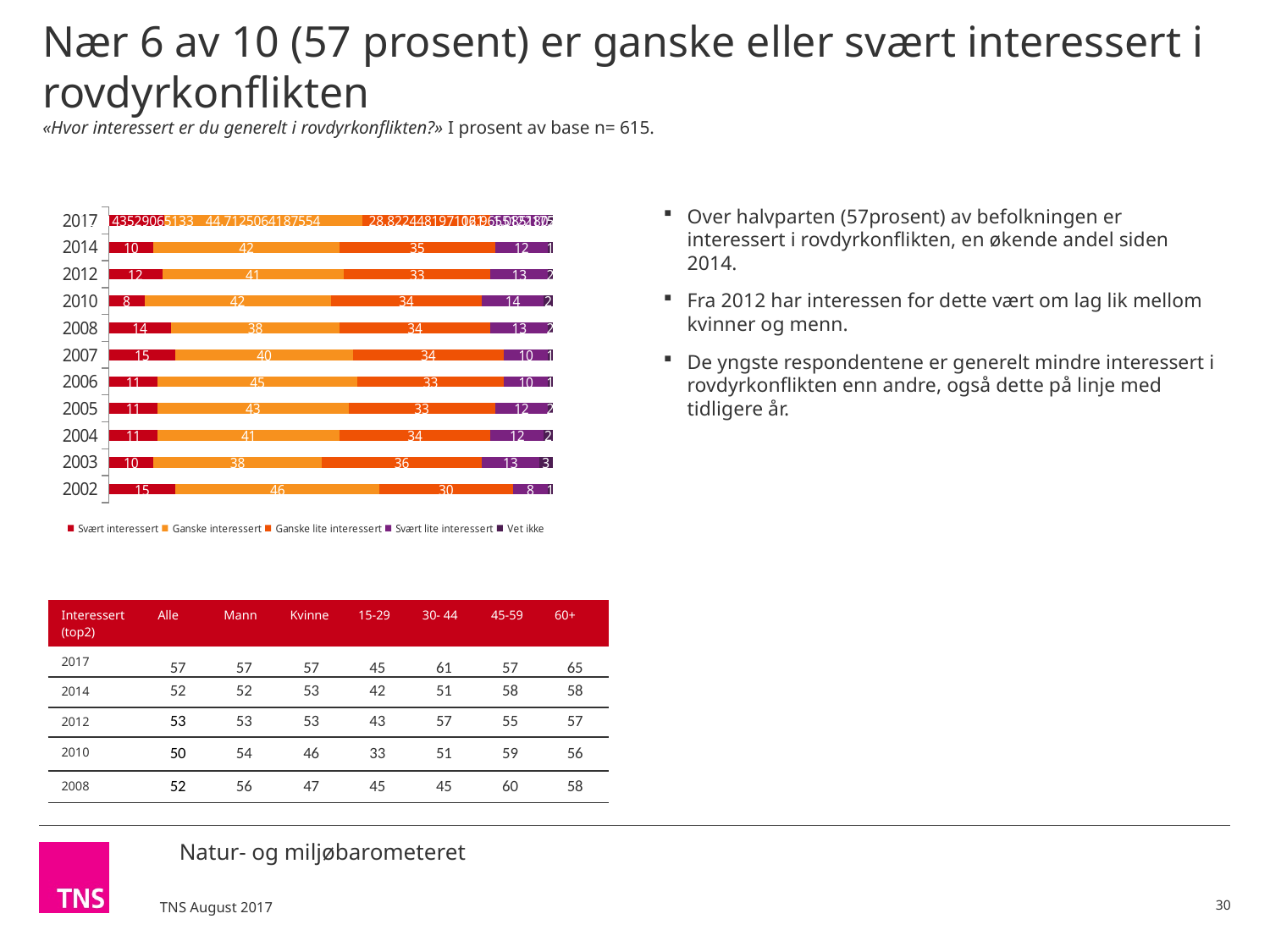
In which year is the 'Svært interessert' value lowest? 2010 What is the total of the stacked bar for 2014? 100 In which year is the 'Ganske interessert' value highest? 2002 How many years are shown as categories in the chart? 11 What kind of chart is shown on the slide? Stacked bar chart What is the difference between the 'Ganske lite interessert' values for 2003 and 2002? 6 What is the value for 'Vet ikke' in 2003? 3 What is the value for 'Svært interessert' in 2010? 8 How many series does the chart legend list? 5 Which year has the larger 'Svært lite interessert' value, 2010 or 2007? 2010 What is the value for 'Ganske interessert' in 2002? 46 Which series is listed first in the chart legend? Svært interessert